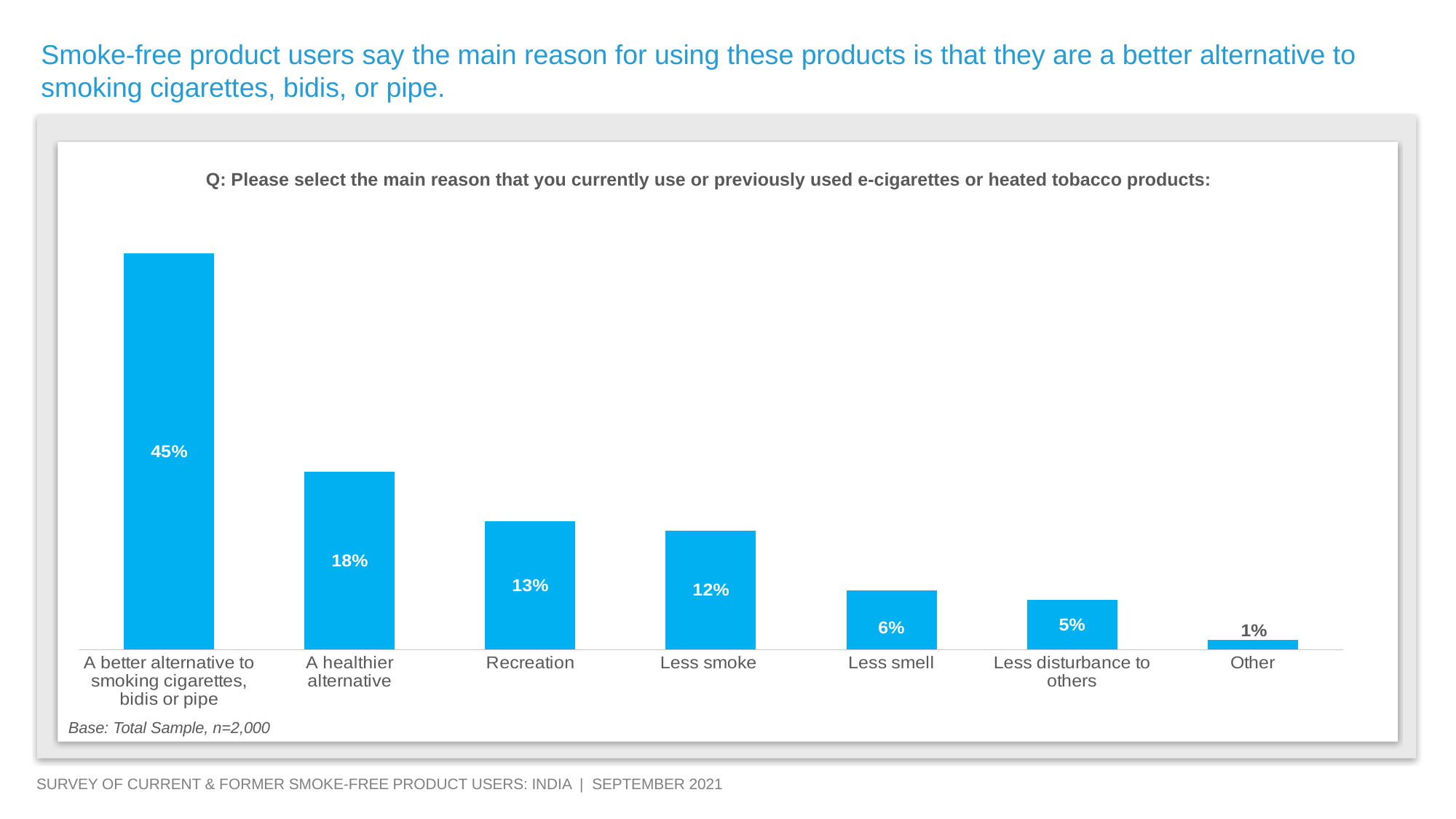
What is the value shown for 'Recreation'? 13% What percentage of respondents selected 'A better alternative to smoking cigarettes, bidis or pipe' as their main reason? 45% How many reason categories are shown in the chart? 7 Which reason has the lowest percentage? Other What percentage selected 'Less disturbance to others'? 5% Which has a higher value, 'Less smell' or 'Less disturbance to others'? Less smell What is the difference in percentage points between 'A healthier alternative' and 'Less smoke'? 6 What is the base sample size stated below the chart? n=2,000 Which reason has the highest percentage? A better alternative to smoking cigarettes, bidis or pipe Do the values rise or fall moving from left to right across the categories? Fall What is the difference in percentage points between 'A better alternative to smoking cigarettes, bidis or pipe' and 'A healthier alternative'? 27 What type of chart is shown on the slide? Bar chart